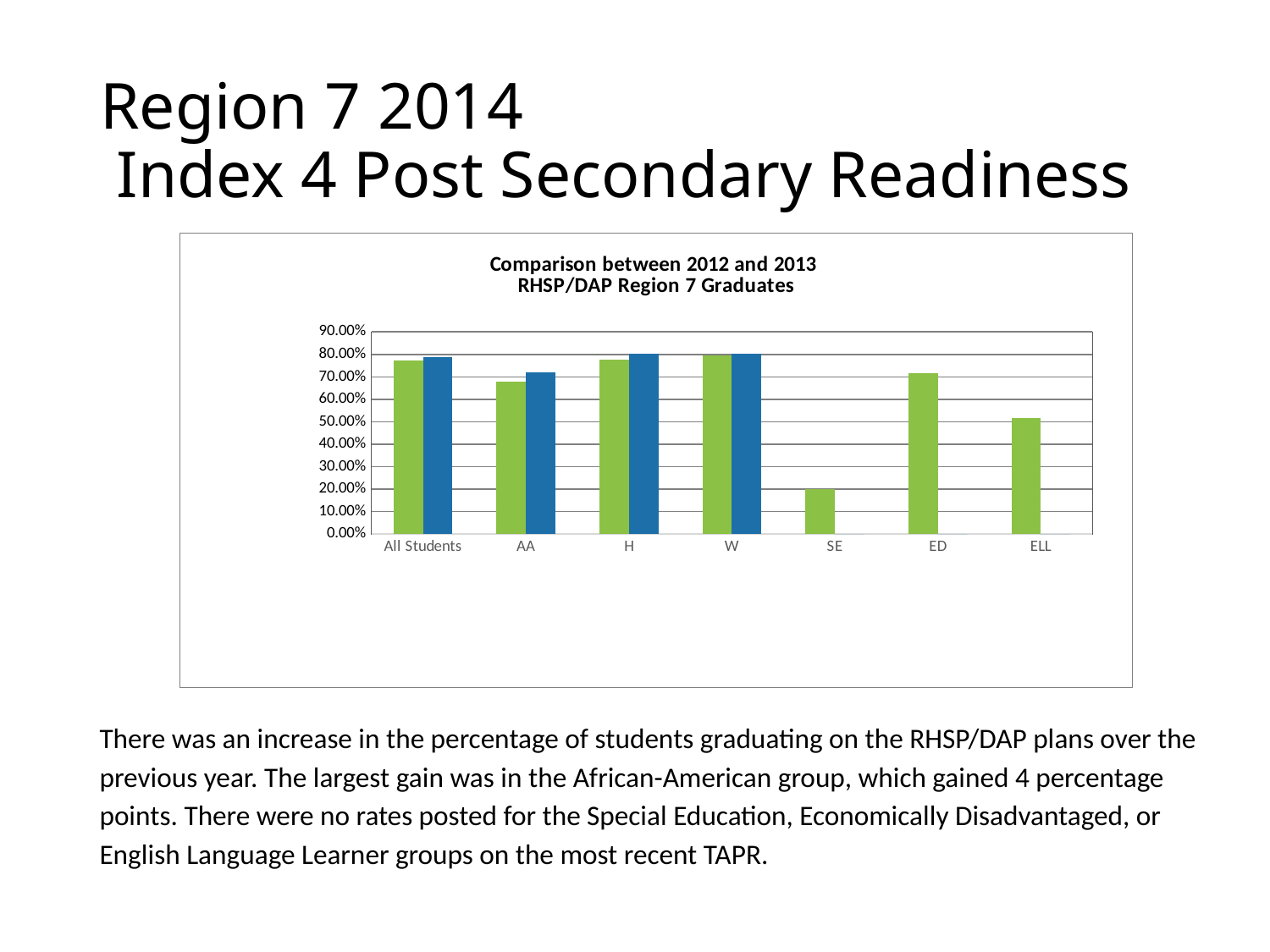
Is the value of the green bar for ELL greater or less than 40.00%? greater Which category has the lowest bar in the chart? SE Which is larger, the green bar for SE or the green bar for ELL? ELL How many categories are shown on the x axis of the chart? 7 For the AA category, which bar is taller, the green one or the blue one? the blue one Which is larger, the green bar for ED or the green bar for ELL? ED Is the value of the green bar for ED greater or less than 60.00%? greater What kind of chart is shown on the slide? bar chart Is the value of the green bar for AA greater or less than 60.00%? greater What is the title of the chart? Comparison between 2012 and 2013 RHSP/DAP Region 7 Graduates Which categories in the chart have only a green bar and no blue bar? SE, ED, ELL